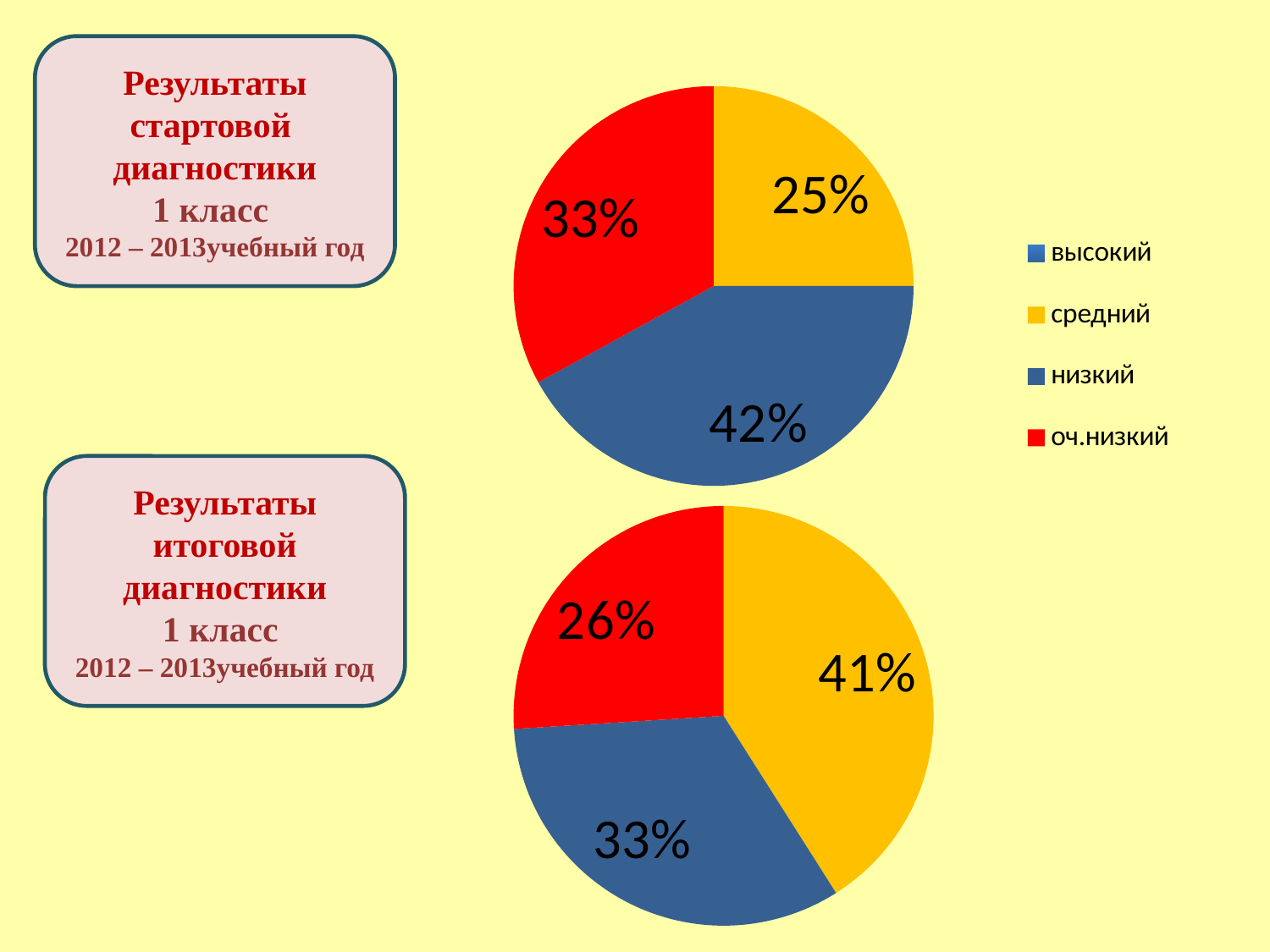
In the top pie chart (Результаты стартовой диагностики), which is larger: средний or оч.низкий? оч.низкий In the top pie chart (Результаты стартовой диагностики), what is the difference between the blue slice and the средний slice? 17 percentage points In the top pie chart (Результаты стартовой диагностики), what percentage is shown for оч.низкий? 33% What colour represents средний in the legend? Yellow How many entries does the legend list? 4 In the bottom pie chart (Результаты итоговой диагностики), what percentage is shown for оч.низкий? 26% In the bottom pie chart (Результаты итоговой диагностики), what percentage is shown for средний? 41% In the bottom pie chart (Результаты итоговой диагностики), what is the difference between средний and оч.низкий? 15 percentage points In the top pie chart (Результаты стартовой диагностики), what percentage is shown for средний? 25% In the top pie chart (Результаты стартовой диагностики), what percentage is shown on the largest slice? 42% In the bottom pie chart (Результаты итоговой диагностики), which labelled category has the smallest slice? оч.низкий What type of chart is used on this slide? Pie chart